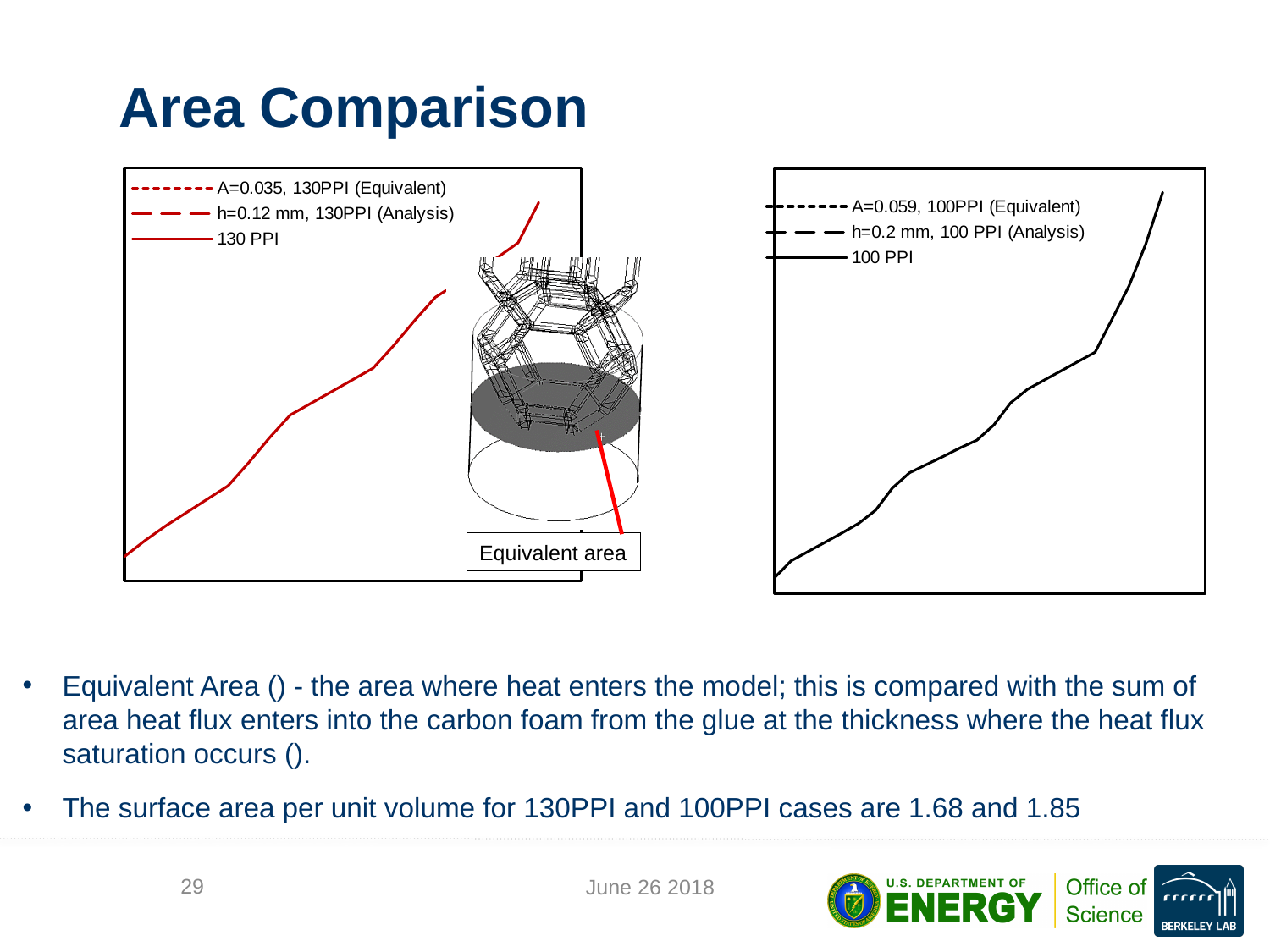
What kind of chart is the left chart on the slide? Line chart How many series does the legend of the left chart list? 3 What kind of chart is the right chart on the slide? Line chart In the right chart, what is the legend entry for the dotted line? A=0.059, 100PPI (Equivalent) In the left chart, what colour is the plotted 130 PPI line? Red In the right chart, does the plotted 100 PPI line rise or fall from left to right? Rise How many series does the legend of the right chart list? 3 In the left chart, does the plotted 130 PPI line rise or fall from left to right? Rise